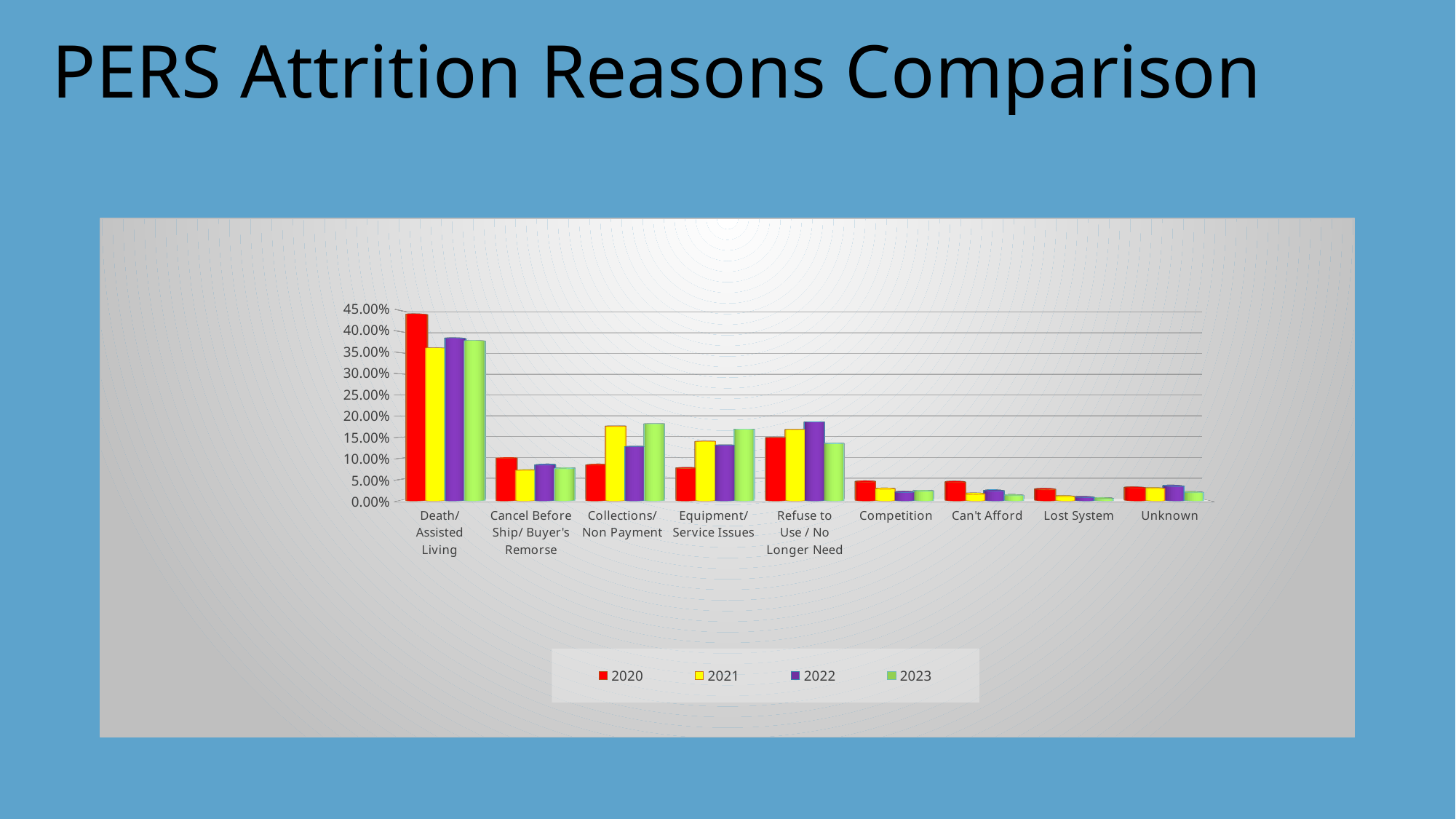
Which category has the highest value for 2020? Death/ Assisted Living For Equipment/ Service Issues, which is larger: the 2020 value or the 2023 value? 2023 How many series does the legend list? 4 What kind of chart is shown on the slide? bar chart Which year has the lowest value for Collections/ Non Payment? 2020 Is the 2021 value for Death/ Assisted Living greater or less than 40.00%? less Is the 2022 value for Refuse to Use / No Longer Need greater or less than 15.00%? greater For Collections/ Non Payment, which is larger: the 2020 value or the 2021 value? 2021 Is the 2020 value for Death/ Assisted Living greater or less than 40.00%? greater How many attrition reason categories are shown on the x axis? 9 What is the title of the slide? PERS Attrition Reasons Comparison What are the entries listed in the legend? 2020, 2021, 2022, 2023